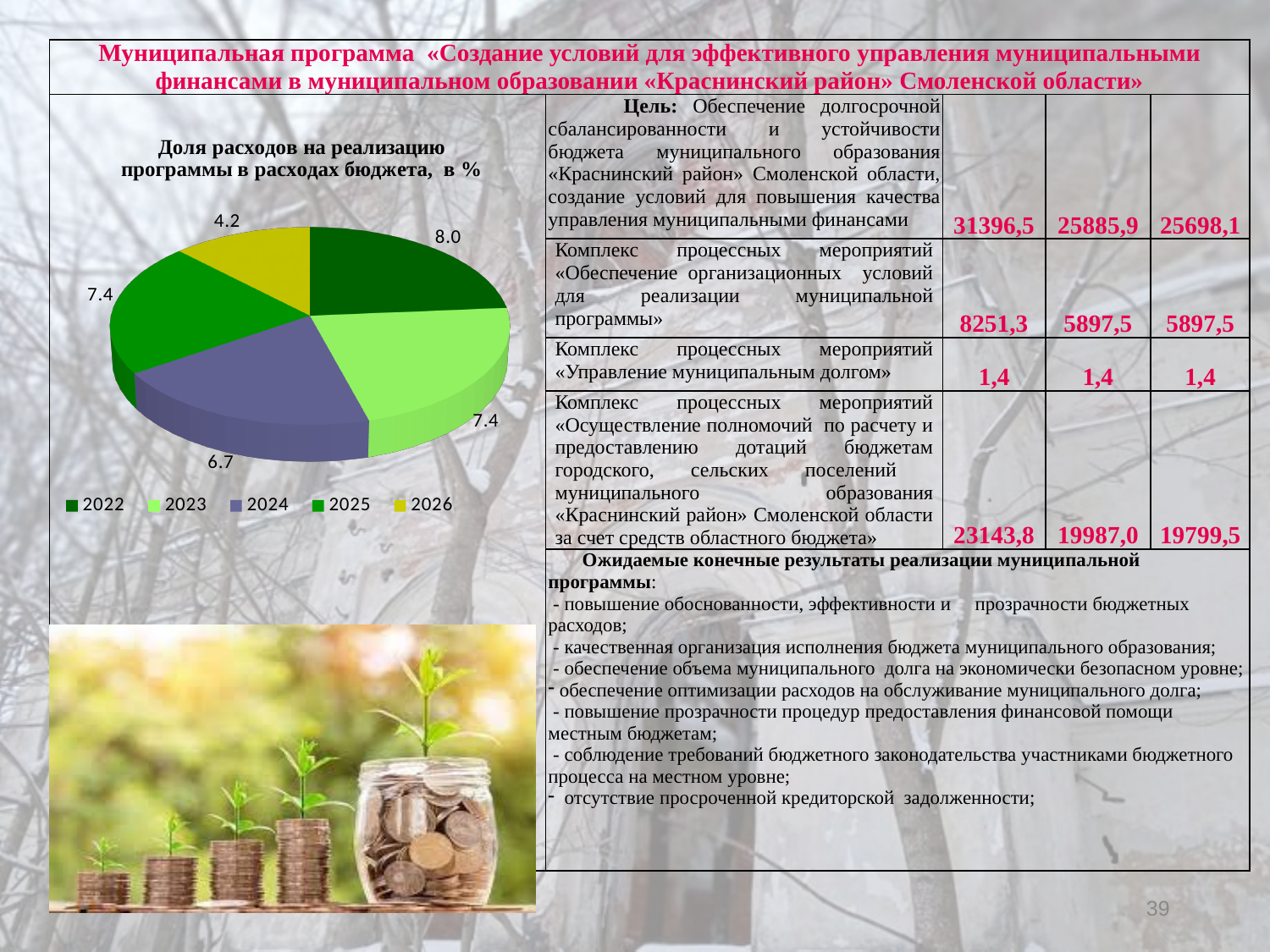
How many slices does the pie chart have? 5 Which year has the smallest slice in the pie chart? 2026 Which year has the largest slice in the pie chart? 2022 What is the value for 2024 in the pie chart? 6.7 What type of chart is shown on the slide? Pie chart What is the value for 2026 in the pie chart? 4.2 What is the title of the pie chart? Доля расходов на реализацию программы в расходах бюджета, в % What is the value for 2022 in the pie chart? 8.0 What is the difference between the values for 2022 and 2026 in the pie chart? 3.8 What is the value for 2023 in the pie chart? 7.4 Which is larger in the pie chart, the value for 2024 or the value for 2026? 2024 What is the difference between the values for 2023 and 2024 in the pie chart? 0.7